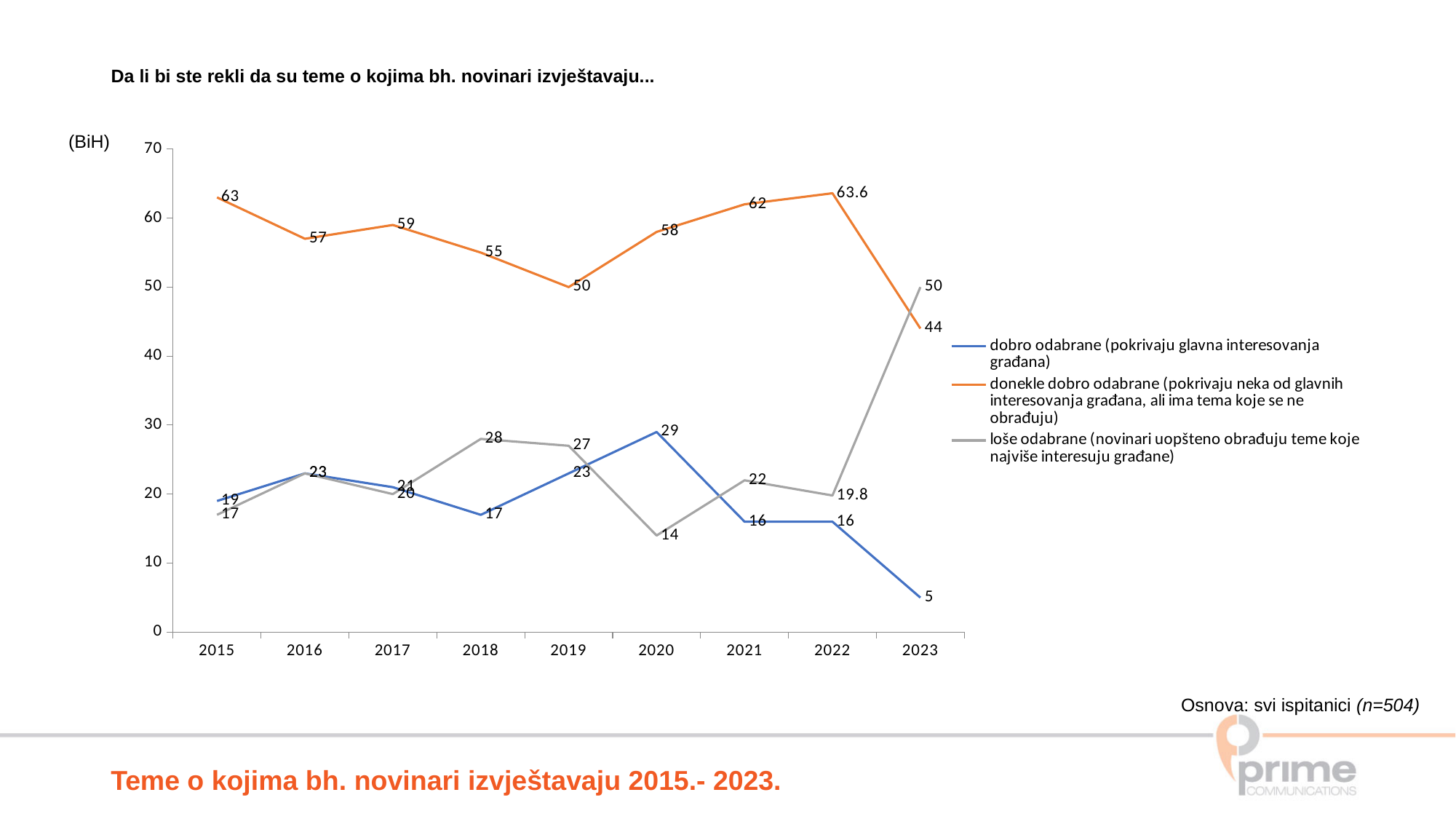
What is the value for 'donekle dobro odabrane' in 2022? 63.6 Does the 'dobro odabrane' line rise or fall from 2020 to 2023? fall In which year does 'donekle dobro odabrane' have its lowest value? 2023 In which year does 'dobro odabrane' reach its highest value? 2020 What type of chart is shown on the slide? line chart Which series has the higher value in 2023, 'loše odabrane' or 'donekle dobro odabrane'? loše odabrane What is the value for 'loše odabrane' in 2022? 19.8 What is the value for 'dobro odabrane' in 2023? 5 What colour is the line for 'donekle dobro odabrane'? orange How many years are shown on the x axis? 9 How many series does the legend list? 3 What is the difference between the 'loše odabrane' values in 2023 and 2022? 30.2